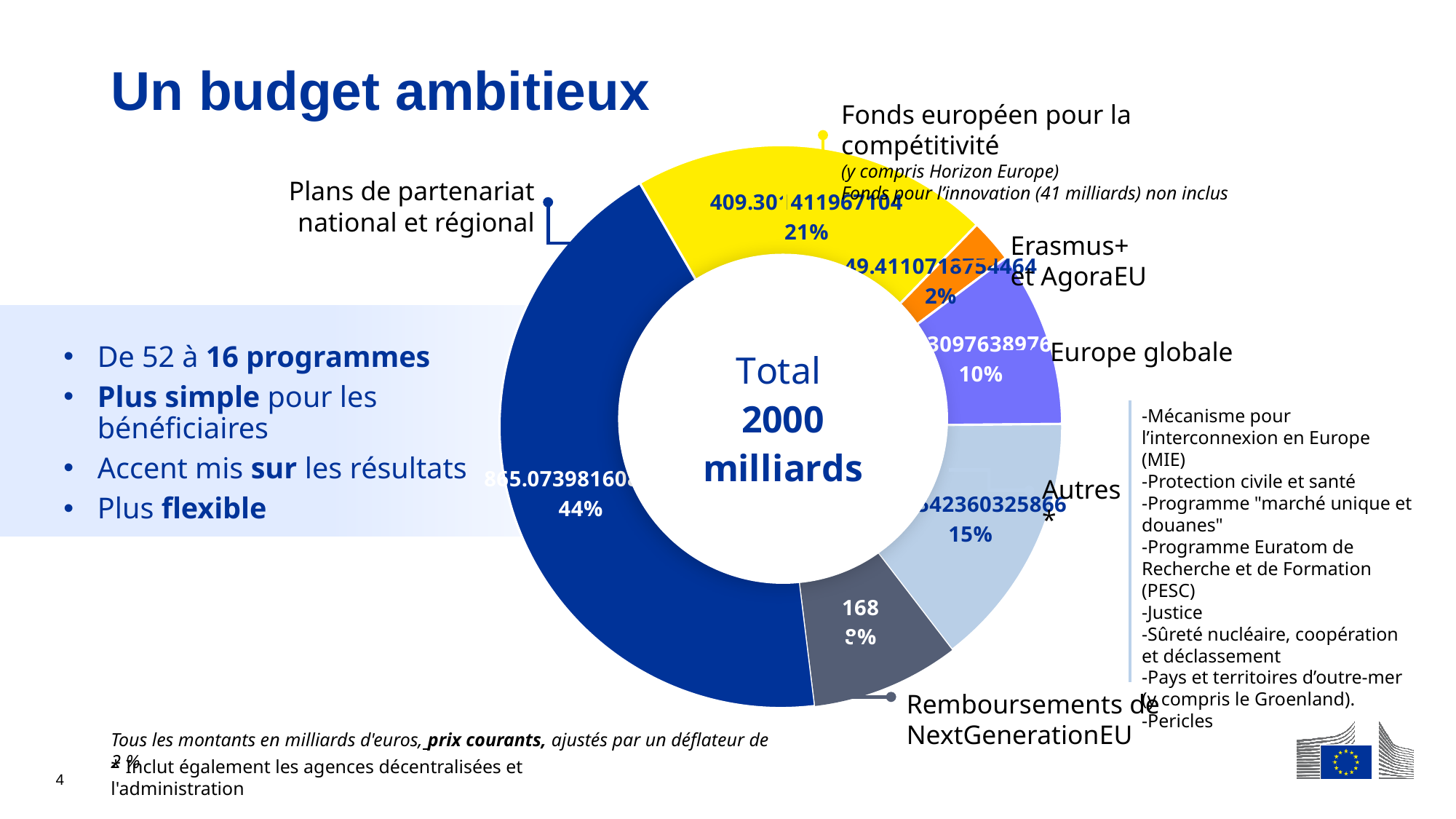
What share of the budget goes to Erasmus+ et AgoraEU? 2% Which category has the smallest slice of the chart? Erasmus+ et AgoraEU What kind of chart is shown on the slide? doughnut chart What share of the budget goes to Plans de partenariat national et régional? 44% Which slice is larger, Autres or Europe globale? Autres What share of the budget goes to the Fonds européen pour la compétitivité? 21% Which category has the largest slice of the chart? Plans de partenariat national et régional How many categories are shown in the chart? 6 What total is displayed in the centre of the chart? Total 2000 milliards By how many percentage points does the share of Plans de partenariat national et régional exceed that of the Fonds européen pour la compétitivité? 23 percentage points